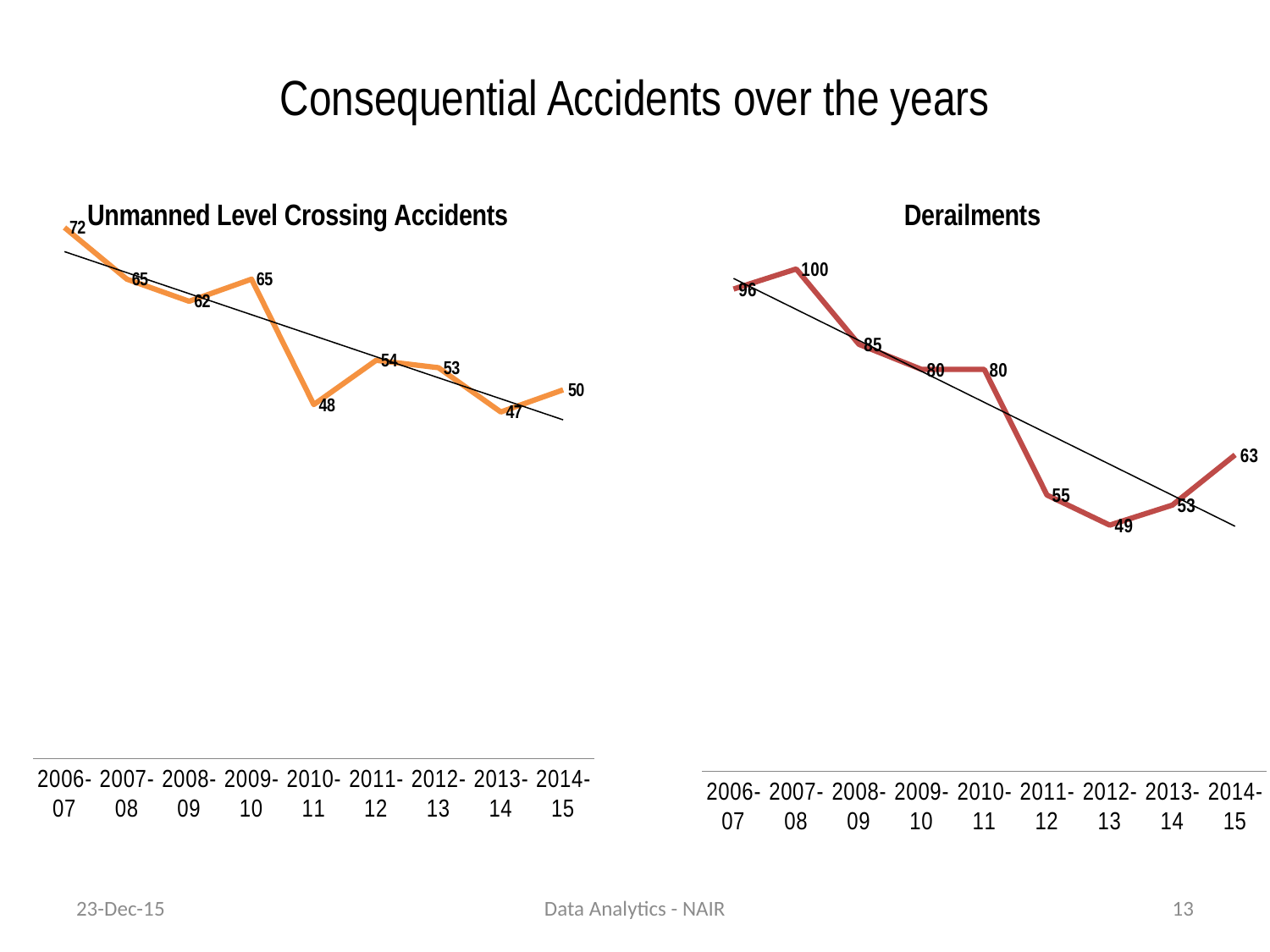
In the Derailments chart, what is the difference between the values for 2006-07 and 2014-15? 33 In the Unmanned Level Crossing Accidents chart, which year has the lowest value? 2013-14 In the Derailments chart, do the values generally rise or fall from 2006-07 to 2014-15? fall In the Derailments chart, which is larger, the value for 2011-12 or the value for 2014-15? 2014-15 In the Derailments chart, what is the value for 2007-08? 100 In the Derailments chart, which year has the lowest value? 2012-13 How many years are plotted in the Derailments chart? 9 In the Unmanned Level Crossing Accidents chart, what is the difference between the values for 2009-10 and 2010-11? 17 What kind of chart is the Unmanned Level Crossing Accidents chart? line chart What is the title of the chart on the right side of the slide? Derailments In the Unmanned Level Crossing Accidents chart, which year has the highest value? 2006-07 In the Unmanned Level Crossing Accidents chart, what is the value for 2010-11? 48